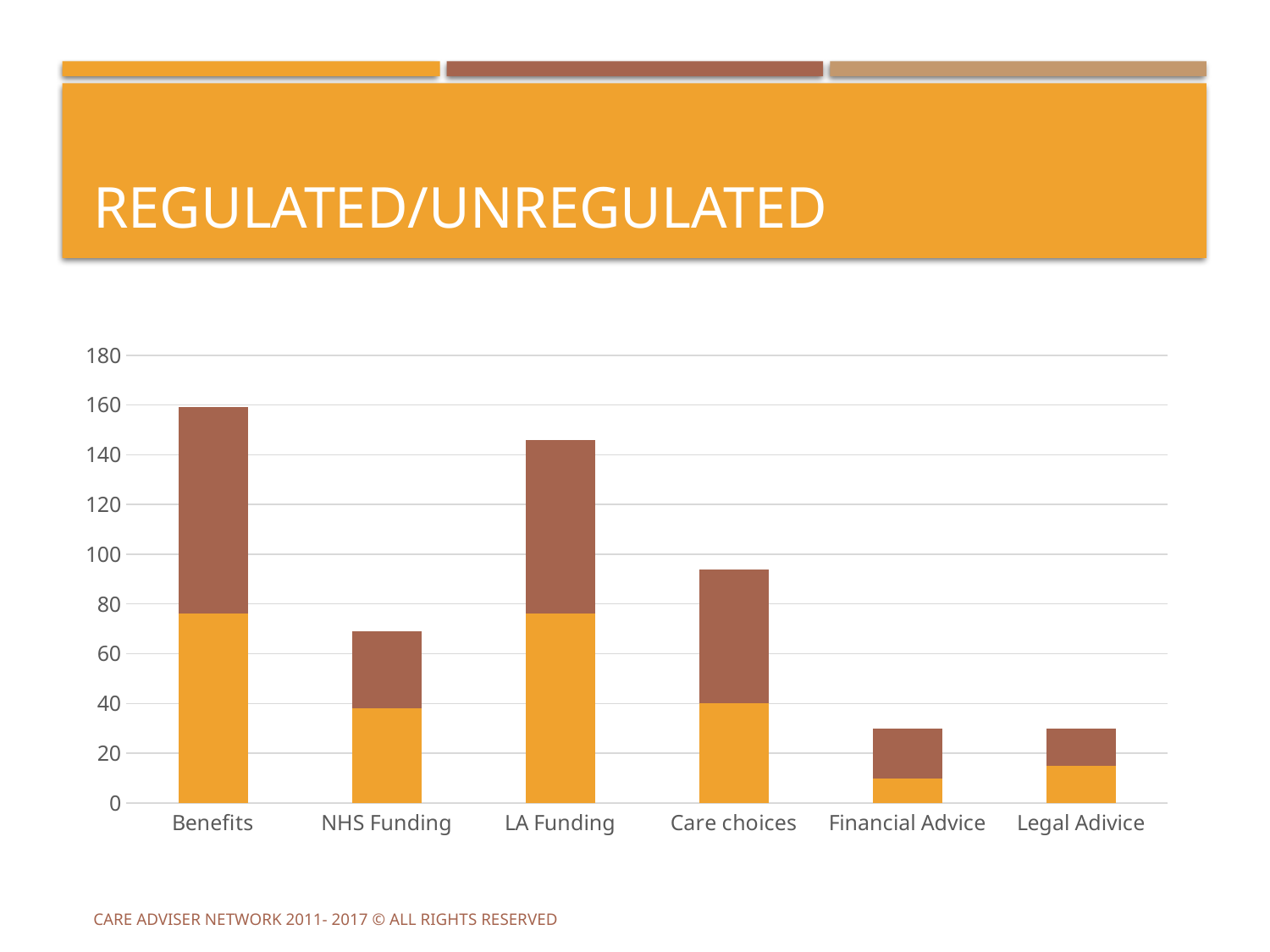
Is the total bar height for Care choices greater or less than 100? less How many categories are shown on the x axis of the chart? 6 Is the total bar height for Financial Advice greater or less than 40? less What is the title of the slide containing the chart? REGULATED/UNREGULATED Which bar is taller, NHS Funding or Care choices? Care choices Is the total bar height for Benefits greater or less than 140? greater What two colours are used for the segments of the stacked bars? Orange and brown What kind of chart is shown on the slide? Stacked bar chart Which category has the tallest bar in the chart? Benefits Which bar is taller, Benefits or LA Funding? Benefits